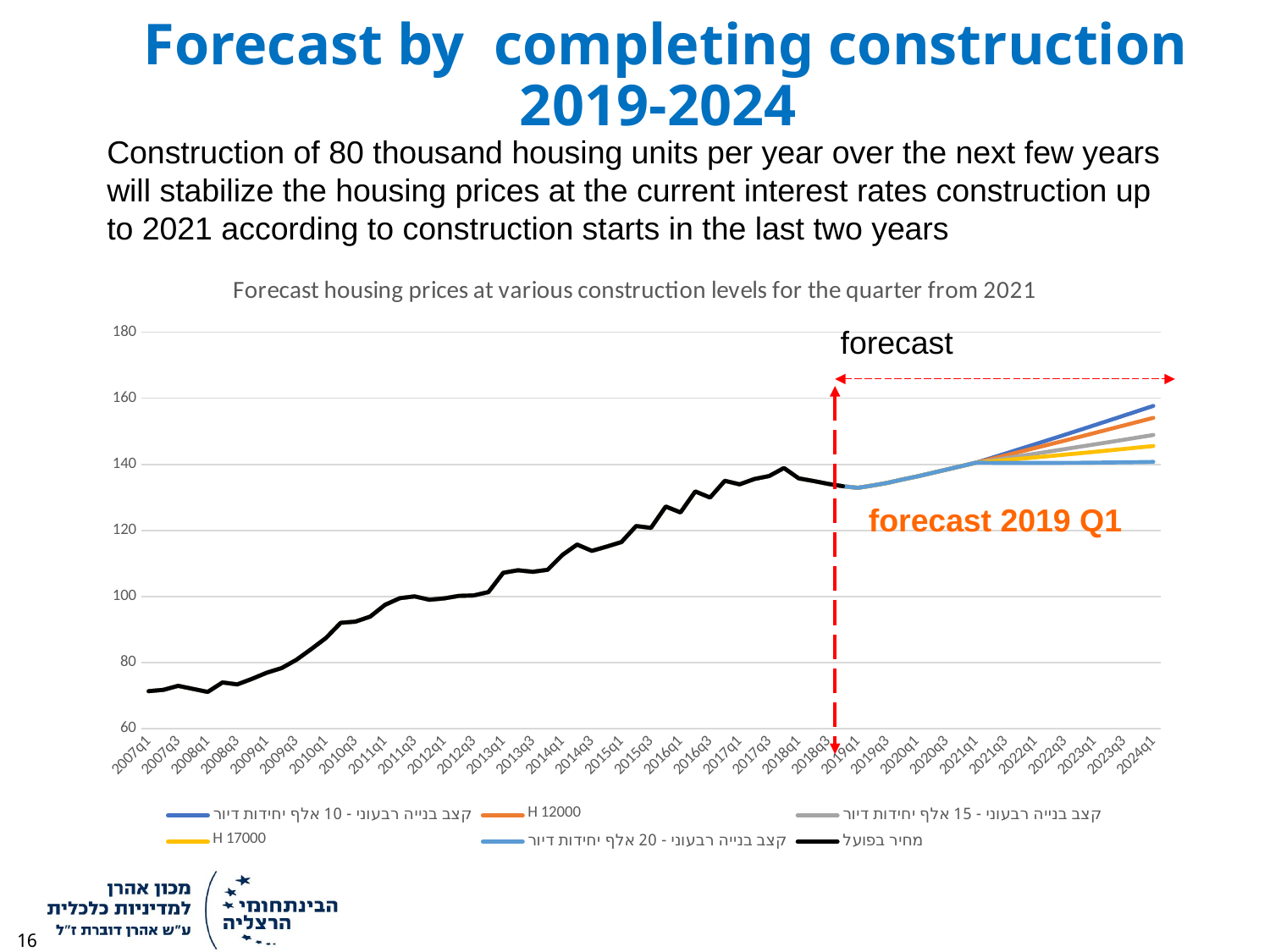
Is the value of the black actual-price line at 2014q1 greater or less than 100? greater Is the value of the black actual-price line at 2018q1 greater or less than 120? greater Which colour is the legend entry "H 12000" drawn in? Orange Does the black actual-price line generally rise or fall from 2007q1 to 2018q1? Rise What kind of chart is shown on the slide? Line chart What is the highest value shown on the vertical axis? 180 Is the value of the black actual-price line at 2007q1 greater or less than 80? less How many series does the chart legend list? 6 Which series has the highest value at 2024q1? קצב בנייה רבעוני - 10 אלף יחידות דיור (dark blue line) At 2024q1, which is larger: the dark blue line (10 thousand units) or the yellow line (H 17000)? The dark blue line (10 thousand units) What is the title of the chart? Forecast housing prices at various construction levels for the quarter from 2021